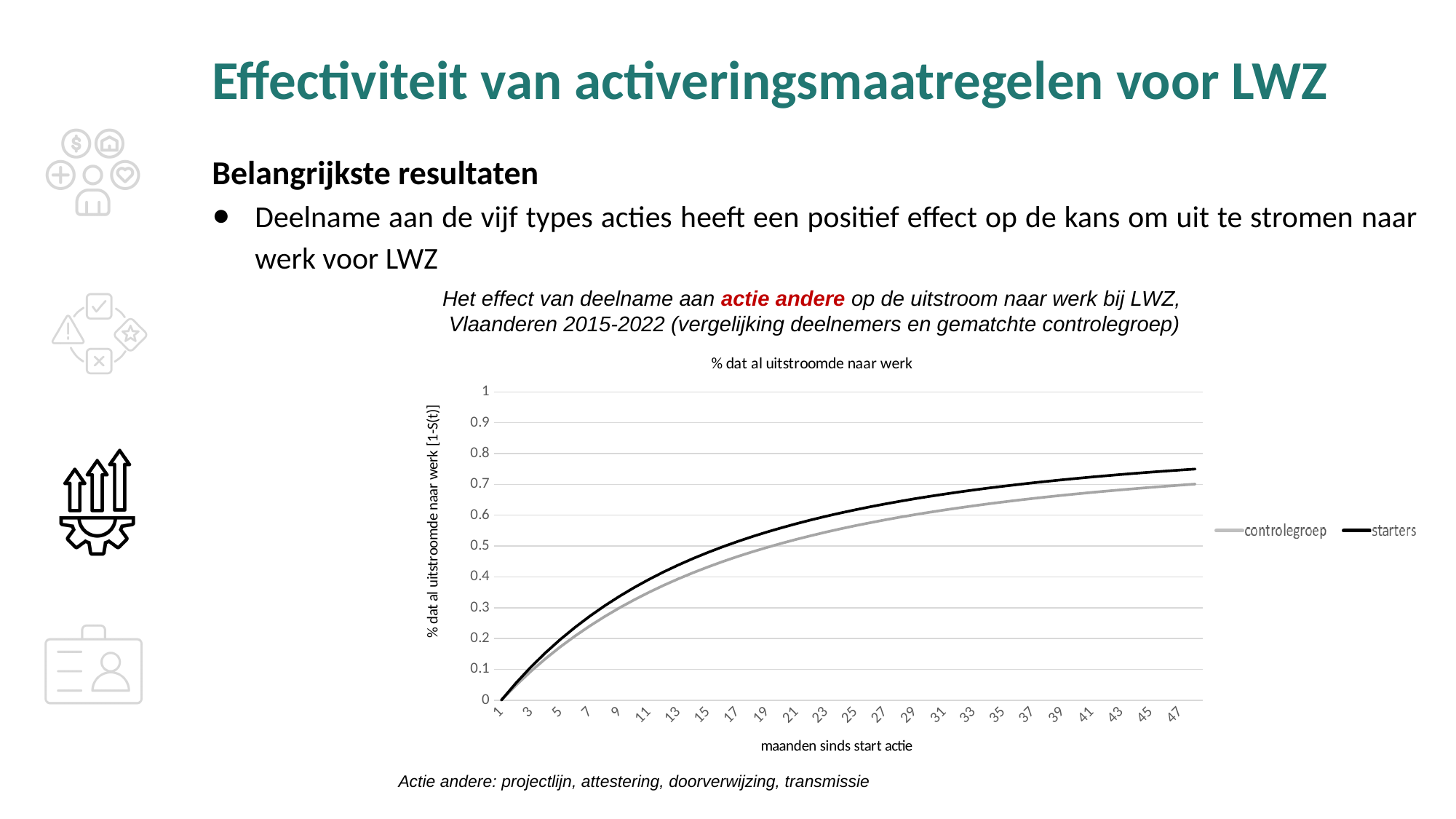
Which two series are listed in the chart's legend? controlegroep and starters Is the value for starters at month 47 greater or less than 0.7? greater Do the values of the starters series rise or fall as the months since the start of the action increase? rise What is the label of the x axis of the chart? maanden sinds start actie What kind of chart is shown on the slide? line chart How many series does the legend of the chart list? 2 At month 13, which series has the higher value, starters or controlegroep? starters Is the value for controlegroep at month 5 greater or less than 0.3? less Is the value for starters at month 21 greater or less than 0.5? greater Do the values of the controlegroep series rise or fall along the x axis? rise At month 47, which series has the higher value, starters or controlegroep? starters